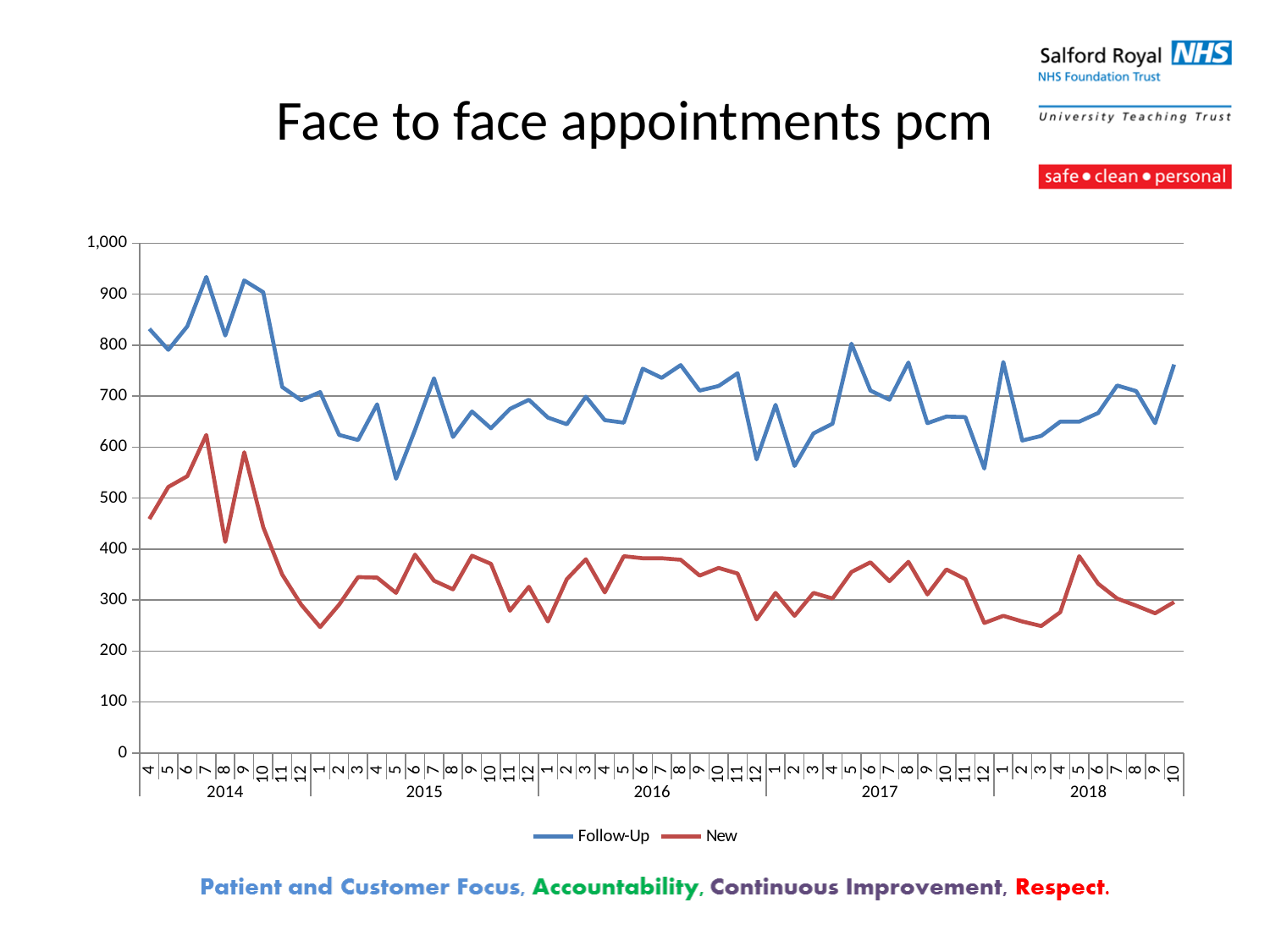
What kind of chart is shown on the slide? line chart In which month and year does the Follow-Up series reach its highest value? 7 2014 How many years are labelled along the x axis? 5 Is the New value for month 1 of 2015 greater or less than 300? less What is the title of the chart? Face to face appointments pcm Does the New series rise or fall between month 4 of 2014 and month 1 of 2015 overall? fall In which month and year does the New series reach its highest value? 7 2014 Which series has the higher values throughout the chart, Follow-Up or New? Follow-Up Is the Follow-Up value for month 5 of 2015 greater or less than 600? less How many series does the legend list? 2 Is the Follow-Up value for month 7 of 2014 greater or less than 900? greater Which series is drawn in red? New